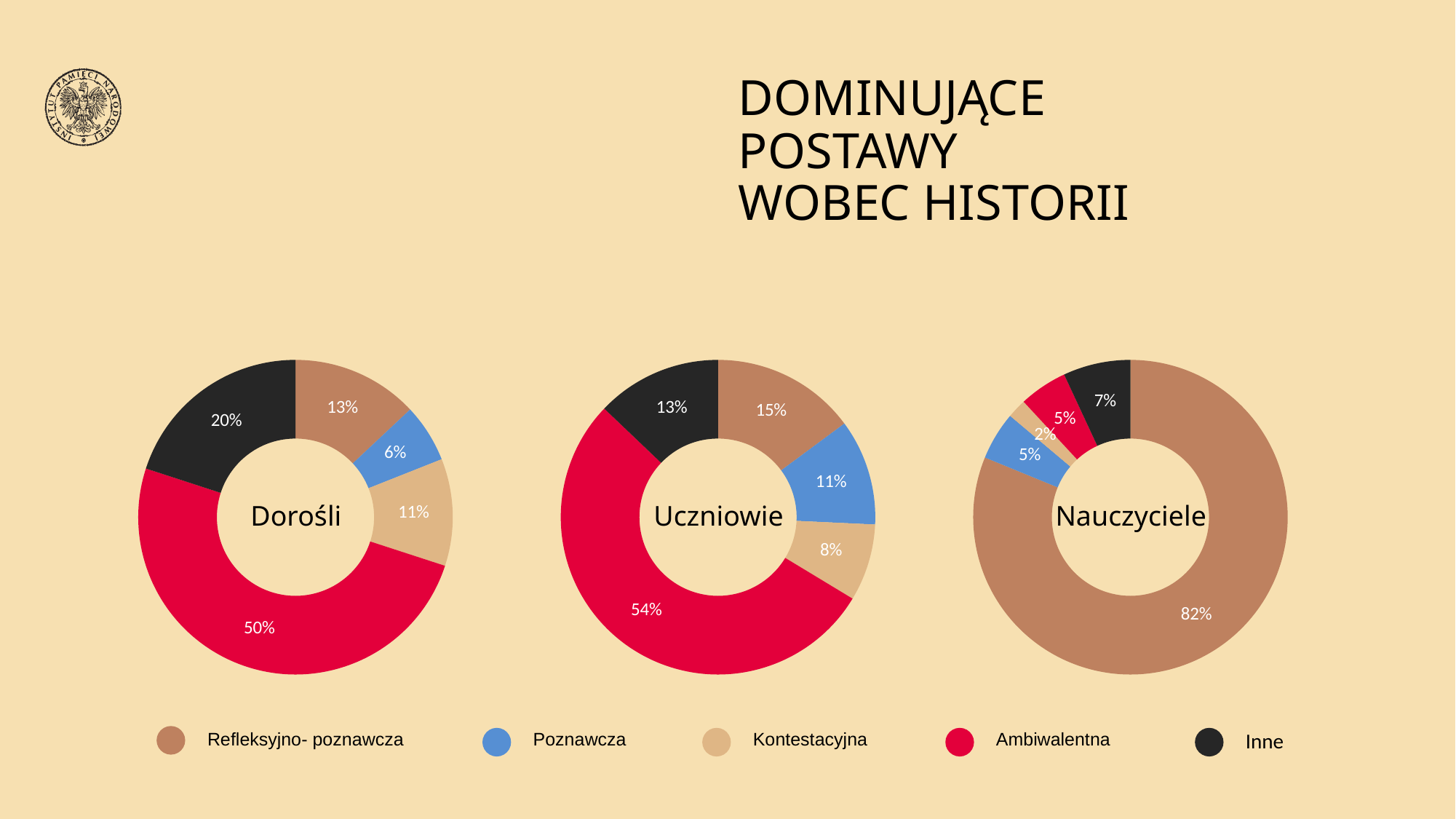
In the Nauczyciele chart, what share is Refleksyjno- poznawcza? 82% In the Dorośli chart, which category has the smallest share? Poznawcza In the Uczniowie chart, what is the difference between Ambiwalentna and Refleksyjno- poznawcza? 39% In the Dorośli chart, which category has the largest share? Ambiwalentna In the Uczniowie chart, which category has the smallest share? Kontestacyjna How many categories does the legend list? 5 Which is larger: Inne in the Dorośli chart or Inne in the Uczniowie chart? Inne in the Dorośli chart In the Nauczyciele chart, what share is Kontestacyjna? 2% In the Uczniowie chart, what share is Poznawcza? 11% In the Dorośli chart, what share is Ambiwalentna? 50% Which colour represents Ambiwalentna in the legend? Red What kind of chart is the Nauczyciele chart? Pie (donut) chart